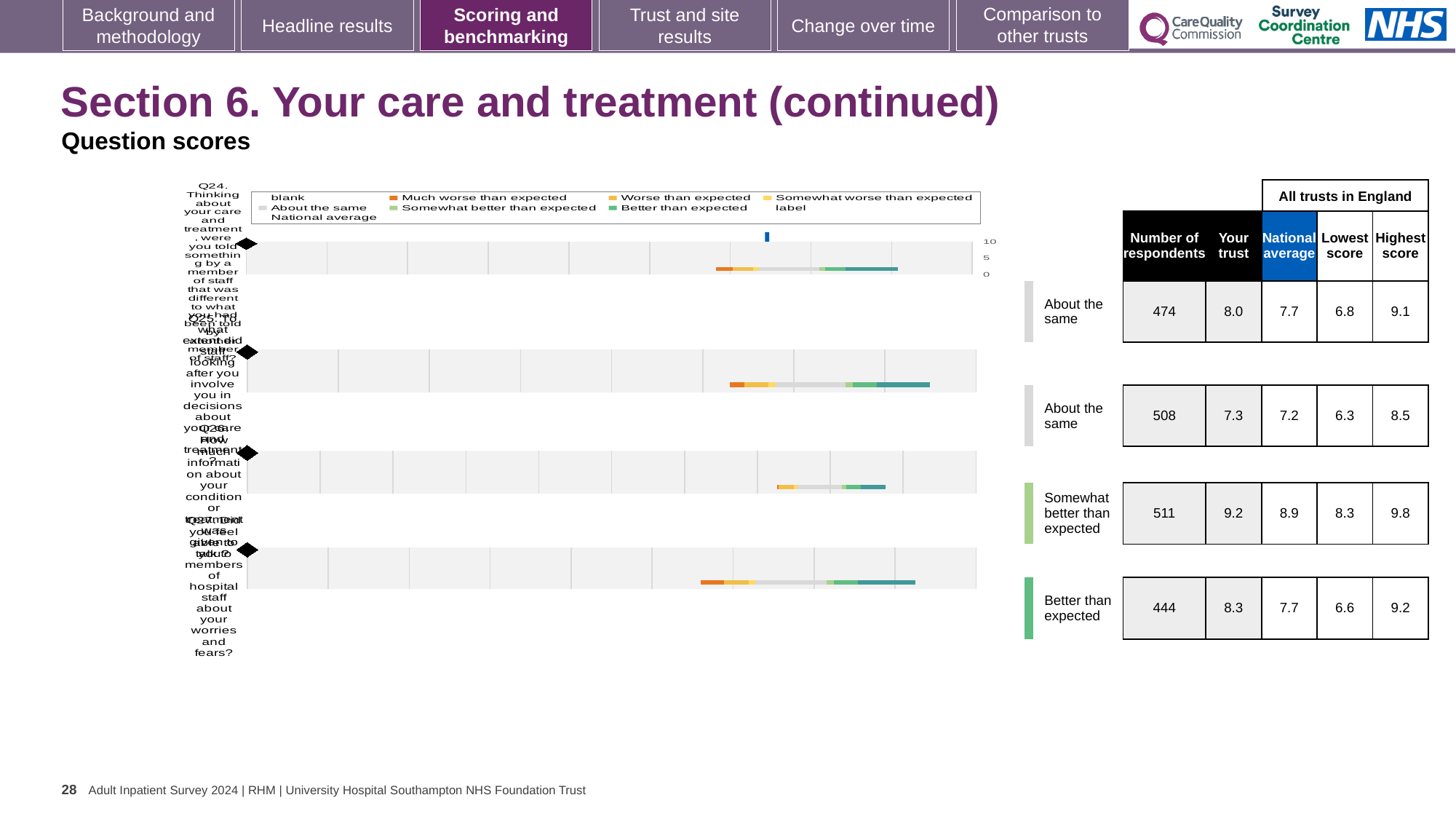
What benchmark category label is shown next to the third question row from the top? Somewhat better than expected In the table, what is the 'Your trust' score for the second question row from the top? 7.3 In the table, what is the highest score for the bottom (fourth) question row? 9.2 How many question bar charts are shown on the slide? 4 Which question row has the highest 'Your trust' score in the table? The third row from the top (9.2) In the table, what is the national average for the third question row from the top? 8.9 Which question row has the lowest 'Lowest score' value in the table? The second row from the top (6.3) For the top question row, what is the difference between the 'Your trust' score and the national average? 0.3 In the table, what is the number of respondents for the first (top) question row? 474 For the bottom question row, which is larger: the 'Your trust' score or the national average? Your trust (8.3) In the chart legend, what colour represents 'Much worse than expected'? Orange What kind of chart is used for the question scores on the left of the slide? Bar chart